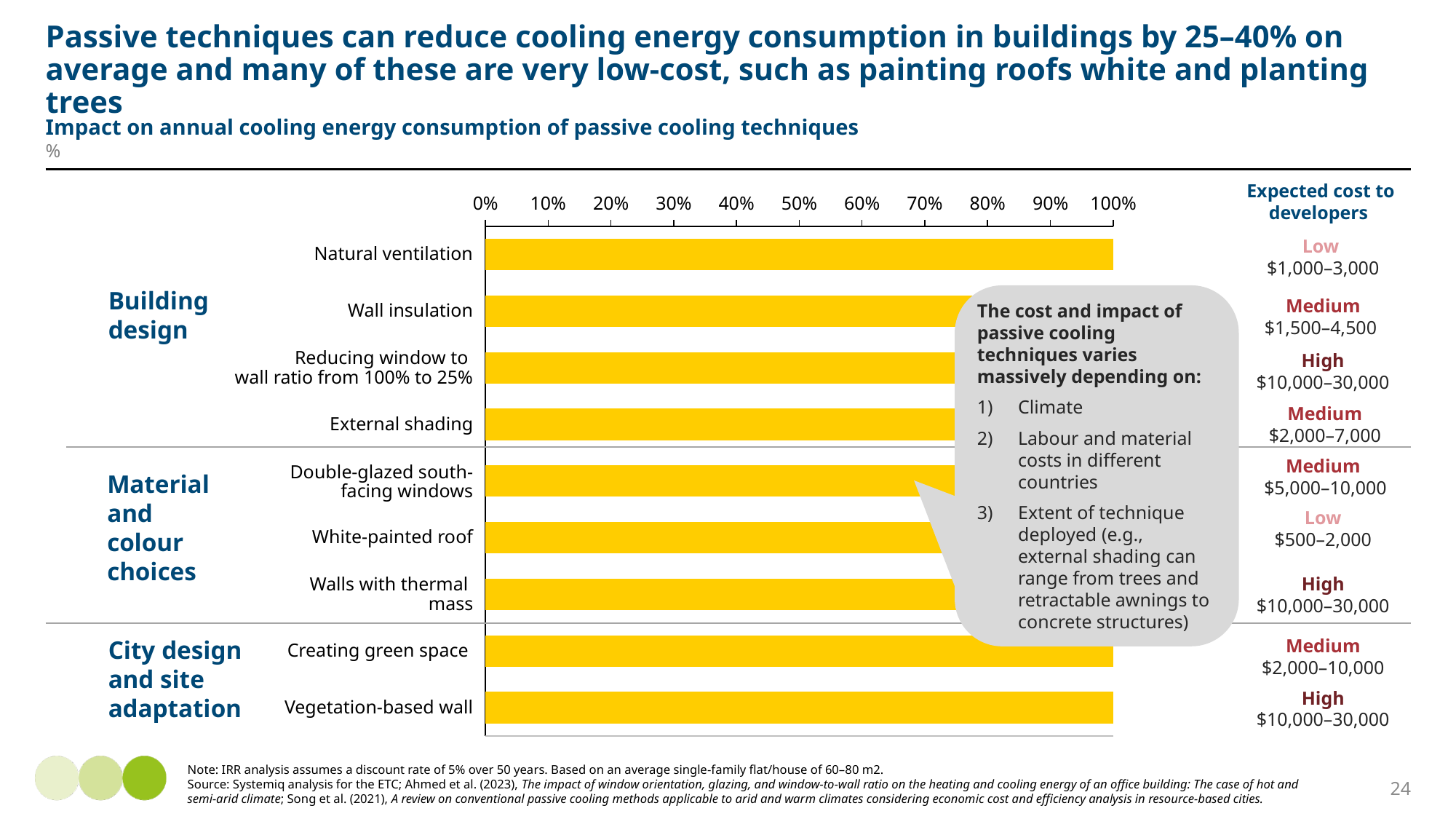
Is the value for Double-glazed south-facing windows greater or less than 60%? greater Which has a larger impact on annual cooling energy consumption, Vegetation-based wall or Double-glazed south-facing windows? Vegetation-based wall Which passive cooling technique has the lowest impact on annual cooling energy consumption in the chart? Double-glazed south-facing windows Is the value for Creating green space greater or less than 80%? greater Is the value for Natural ventilation greater or less than 90%? greater Into how many groups are the techniques in the chart divided? 3 How many passive cooling techniques are plotted in the chart? 9 Which has a larger impact on annual cooling energy consumption, Natural ventilation or Double-glazed south-facing windows? Natural ventilation What kind of chart is shown on the slide? bar chart What is the expected cost to developers shown for Natural ventilation? Low, $1,000–3,000